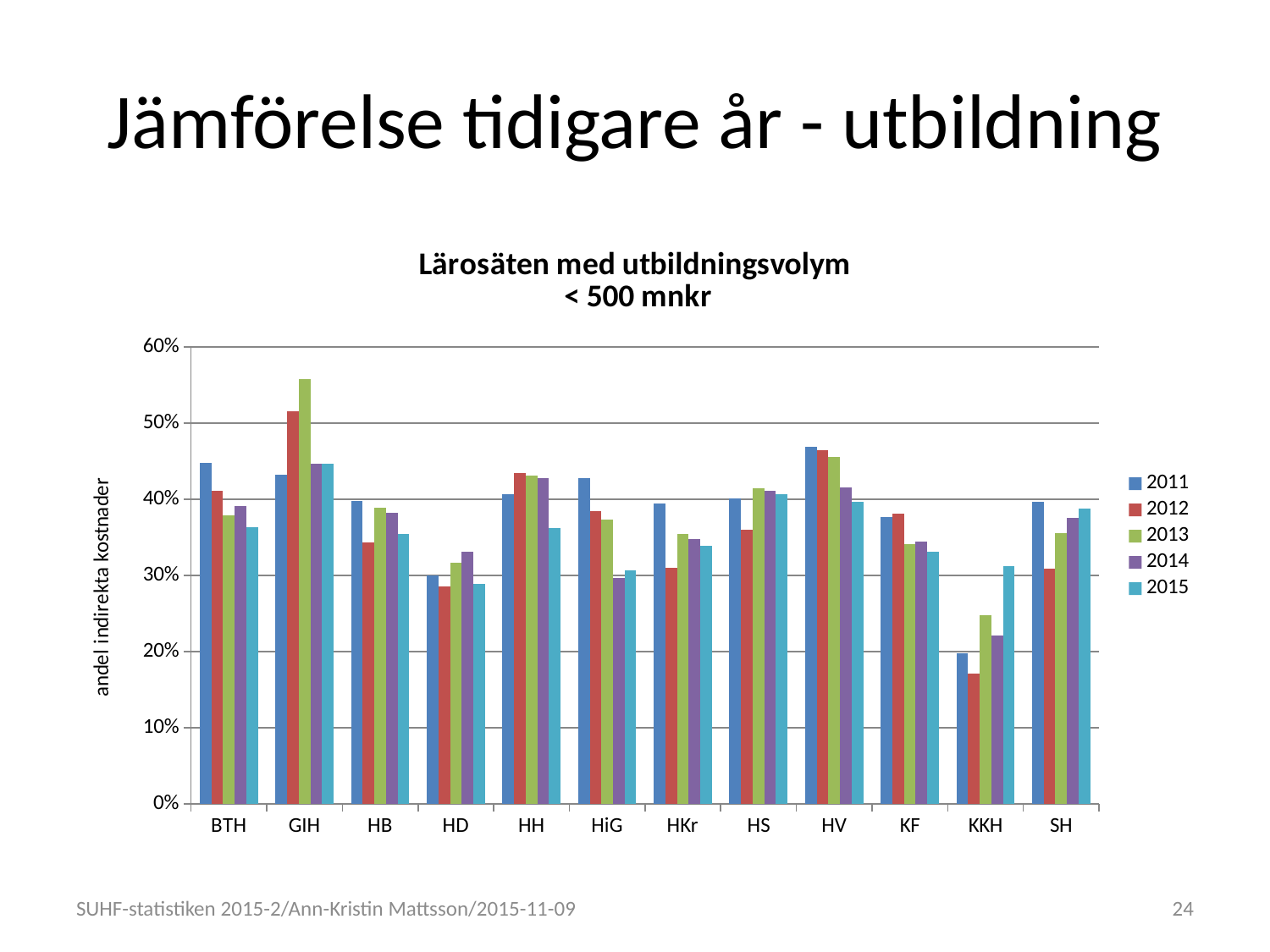
How many categories (institutions) are shown on the x axis? 12 What is the title of the chart? Lärosäten med utbildningsvolym < 500 mnkr Is the value for HD in 2012 greater or less than 30%? less Which is larger, the 2013 value for GIH or the 2013 value for BTH? GIH Which institution and year has the highest bar in the chart? GIH, 2013 Is the value for HV in 2011 greater or less than 40%? greater Which is larger, the 2011 value for KKH or the 2011 value for SH? SH Which institution has the lowest value for 2011? KKH Is the value for KKH in 2012 greater or less than 20%? less What kind of chart is shown on the slide? bar chart How many series does the legend list? 5